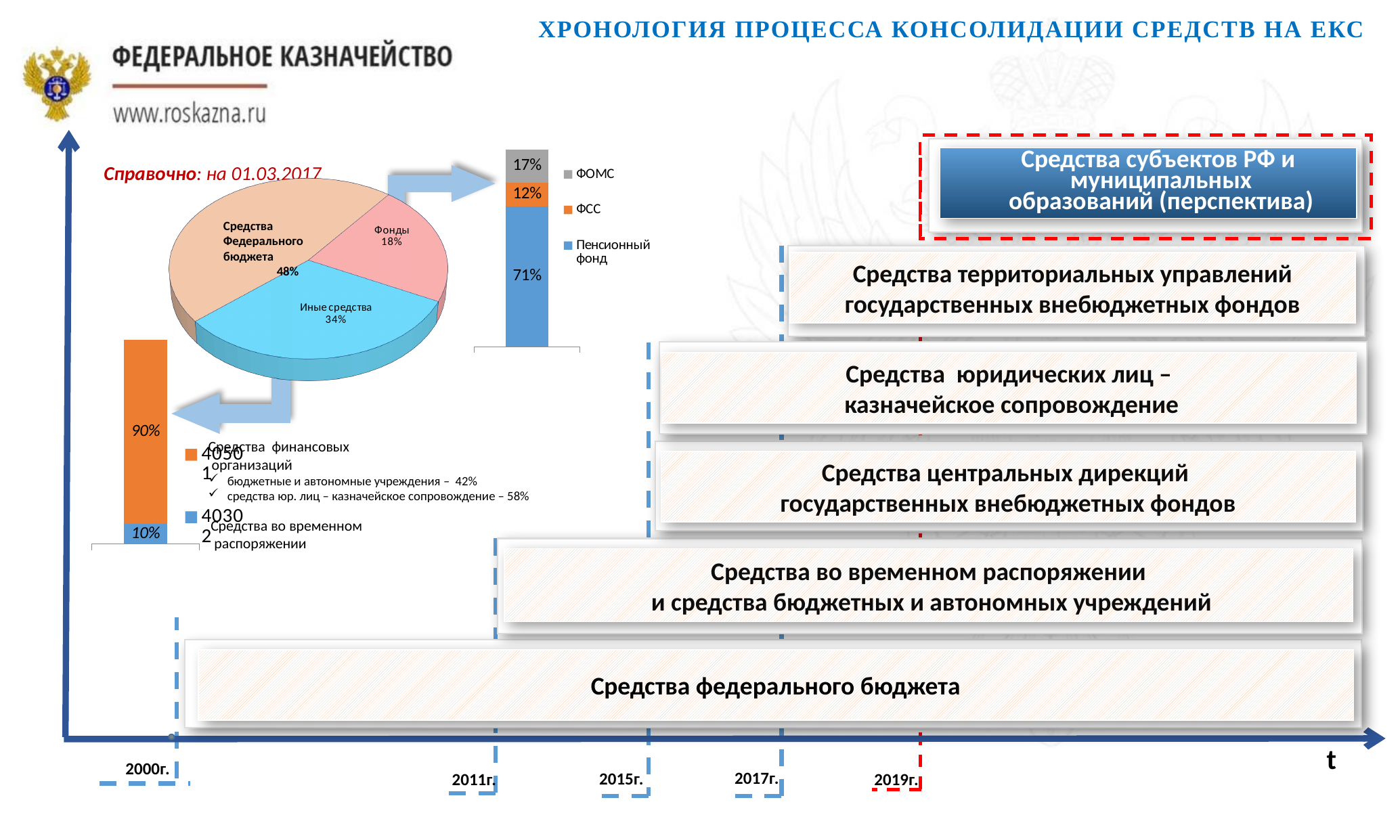
In the pie chart on the left of the slide, which slice is the smallest? Фонды In the pie chart on the left of the slide, what is the difference between the shares of 'Средства Федерального бюджета' and 'Иные средства'? 14% In the pie chart on the left of the slide, how many slices are there? 3 In the pie chart on the left of the slide, which slice is the largest? Средства Федерального бюджета In the pie chart on the left of the slide, what share is labelled for 'Средства Федерального бюджета'? 48% In the stacked bar chart at the top centre of the slide, how many series does the legend list? 3 In the pie chart on the left of the slide, what share is labelled for 'Иные средства'? 34% In the stacked bar chart at the bottom left of the slide, what value is shown for the orange segment ('Средства финансовых организаций')? 90% In the stacked bar chart at the top centre of the slide, what value is shown for 'ФОМС'? 17% In the stacked bar chart at the top centre of the slide, which of 'ФОМС' and 'ФСС' has the larger value? ФОМС In the pie chart on the left of the slide, what share is labelled for 'Фонды'? 18% In the stacked bar chart at the top centre of the slide, what value is shown for 'Пенсионный фонд'? 71%